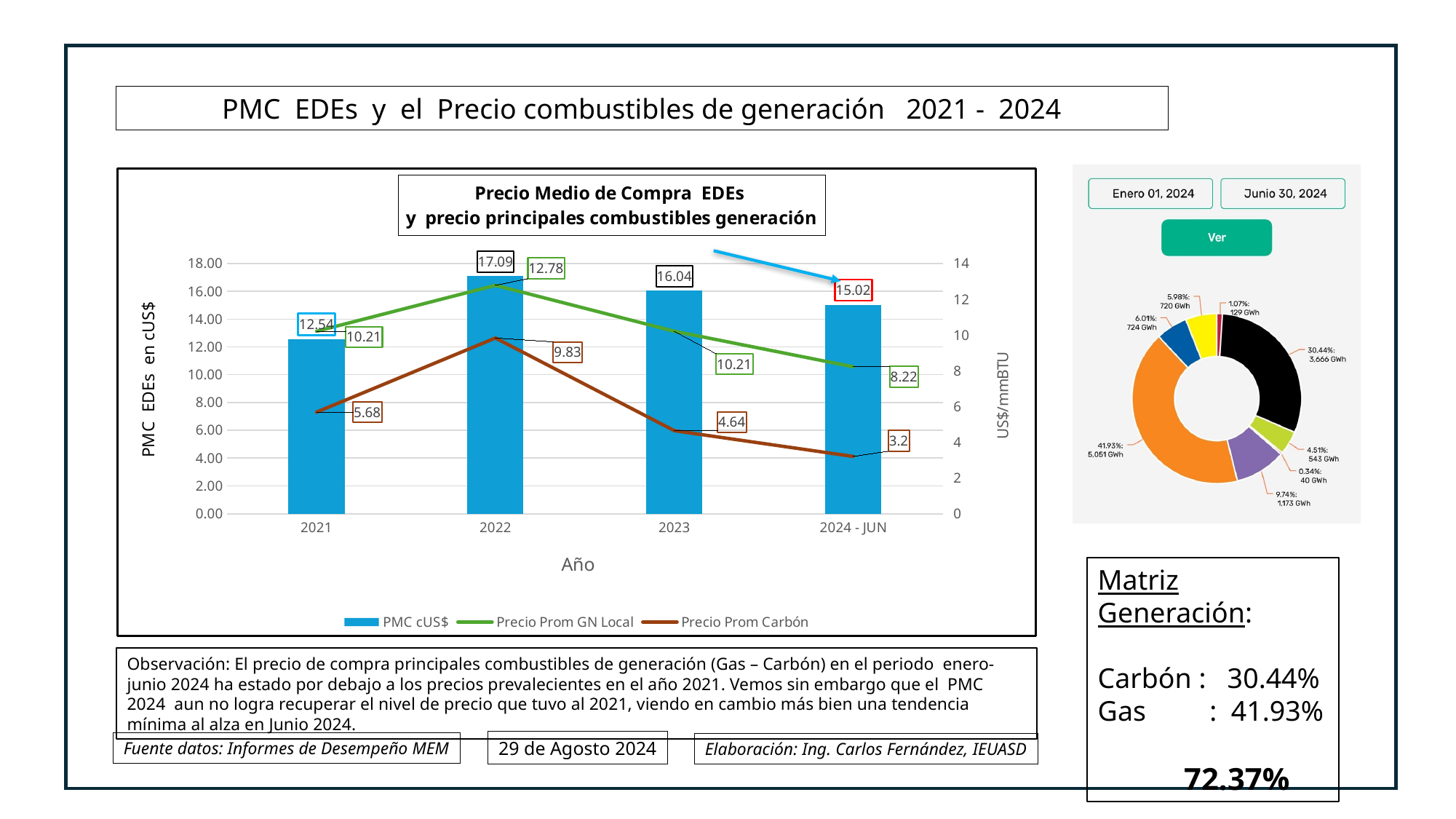
In the chart titled 'Precio Medio de Compra EDEs y precio principales combustibles generación', which is larger in 2023: Precio Prom GN Local or Precio Prom Carbón? Precio Prom GN Local In the chart titled 'Precio Medio de Compra EDEs y precio principales combustibles generación', does the Precio Prom GN Local line rise or fall from 2022 to 2024 - JUN? fall In the chart titled 'Precio Medio de Compra EDEs y precio principales combustibles generación', which year has the highest PMC cUS$ bar? 2022 In the chart titled 'Precio Medio de Compra EDEs y precio principales combustibles generación', what is the PMC cUS$ value for 2022? 17.09 In the chart titled 'Precio Medio de Compra EDEs y precio principales combustibles generación', what is the difference between the PMC cUS$ values for 2022 and 2021? 4.55 In the chart titled 'Precio Medio de Compra EDEs y precio principales combustibles generación', which year has the lowest Precio Prom Carbón value? 2024 - JUN In the donut chart on the right of the slide, what is the share of the largest slice? 41.93% In the donut chart on the right of the slide, how many GWh does the 30.44% slice represent? 3,666 GWh In the chart titled 'Precio Medio de Compra EDEs y precio principales combustibles generación', how many series does the legend list? 3 In the chart titled 'Precio Medio de Compra EDEs y precio principales combustibles generación', how many categories are shown on the x axis? 4 In the chart titled 'Precio Medio de Compra EDEs y precio principales combustibles generación', what is the Precio Prom GN Local value for 2021? 10.21 In the chart titled 'Precio Medio de Compra EDEs y precio principales combustibles generación', what is the Precio Prom Carbón value for 2024 - JUN? 3.2